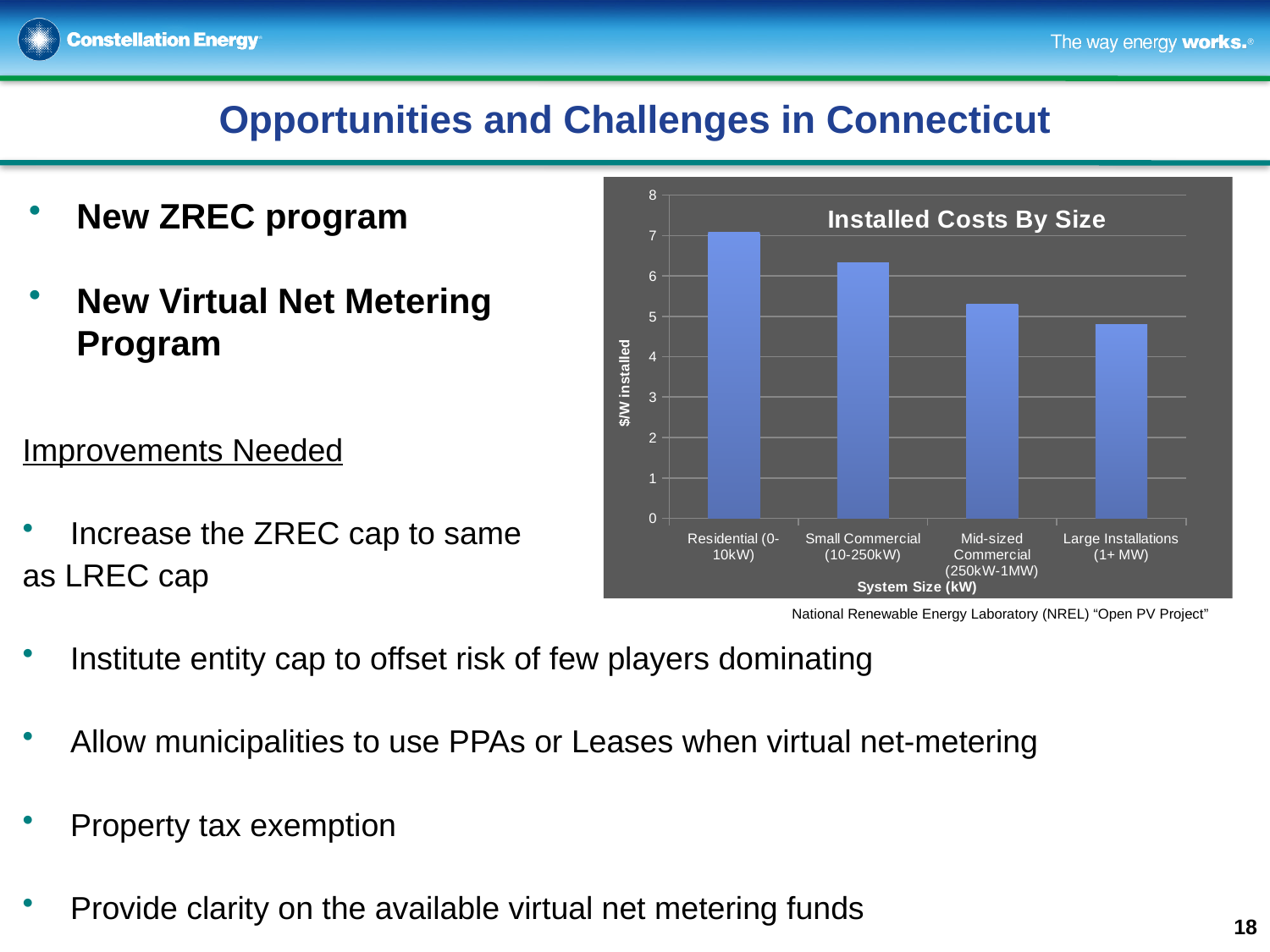
Which system size category has the highest installed cost? Residential (0-10kW) Which system size category has the lowest installed cost? Large Installations (1+ MW) Is the value for Large Installations (1+ MW) greater or less than 5? less What is the label of the vertical axis of the chart? $/W installed How many system size categories are plotted in the chart? 4 Is the value for Mid-sized Commercial (250kW-1MW) greater or less than 6? less Which has a higher installed cost, Small Commercial (10-250kW) or Mid-sized Commercial (250kW-1MW)? Small Commercial (10-250kW) Do the installed costs rise or fall as system size increases along the x axis? fall What is the title of the chart? Installed Costs By Size What kind of chart is shown on the slide? bar chart Is the value for Small Commercial (10-250kW) greater or less than 6? greater